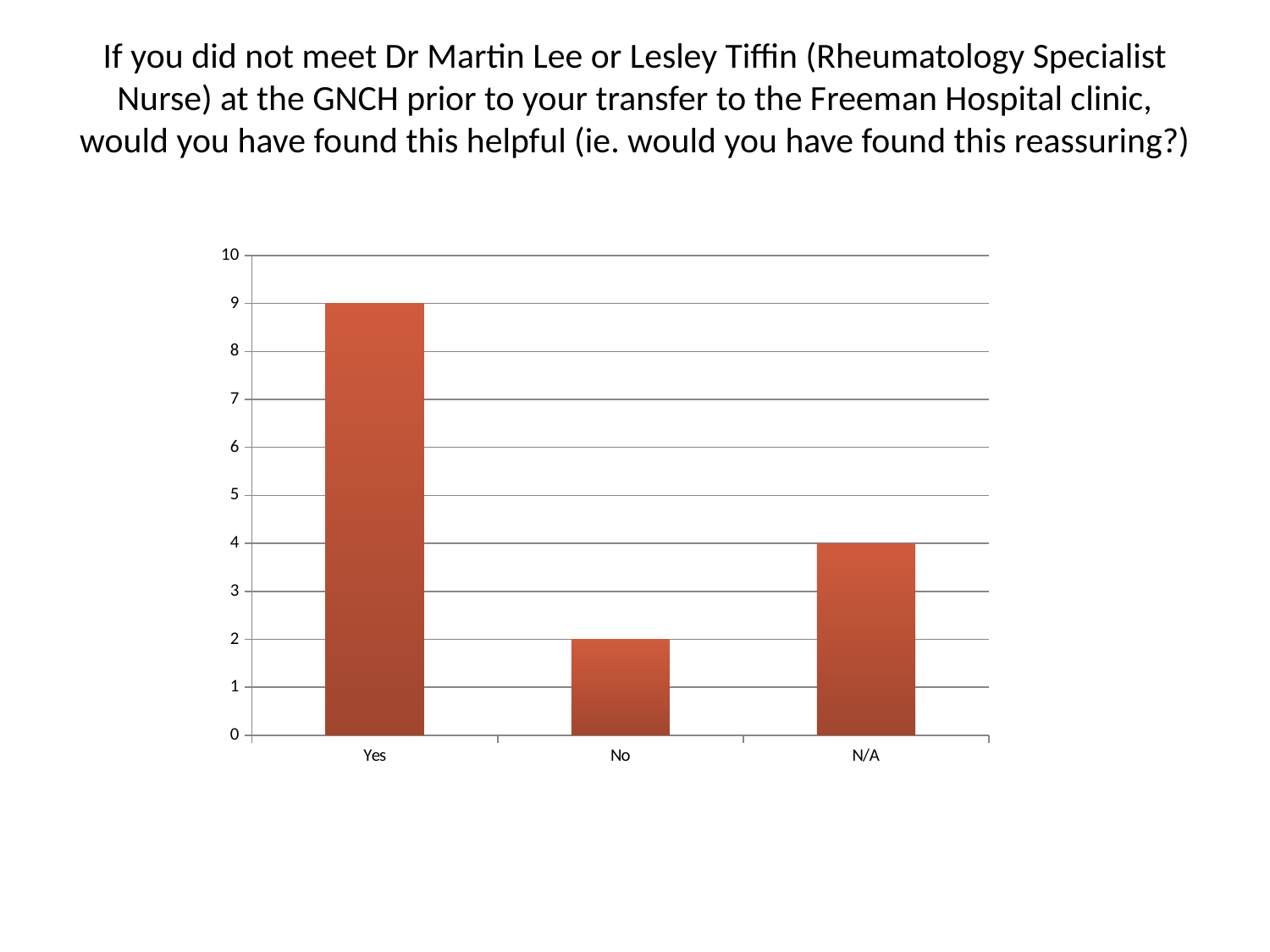
Which category has the highest value? Yes What kind of chart is shown on the slide? bar chart Is the value for Yes greater or less than 5? greater What is the value for No? 2 Which category has the lowest value? No What is the difference between the values for N/A and No? 2 What is the value for N/A? 4 What is the value for Yes? 9 What is the highest value shown on the y axis? 10 How many categories are shown on the x axis? 3 Which is larger, the value for N/A or the value for No? N/A What is the difference between the values for Yes and No? 7